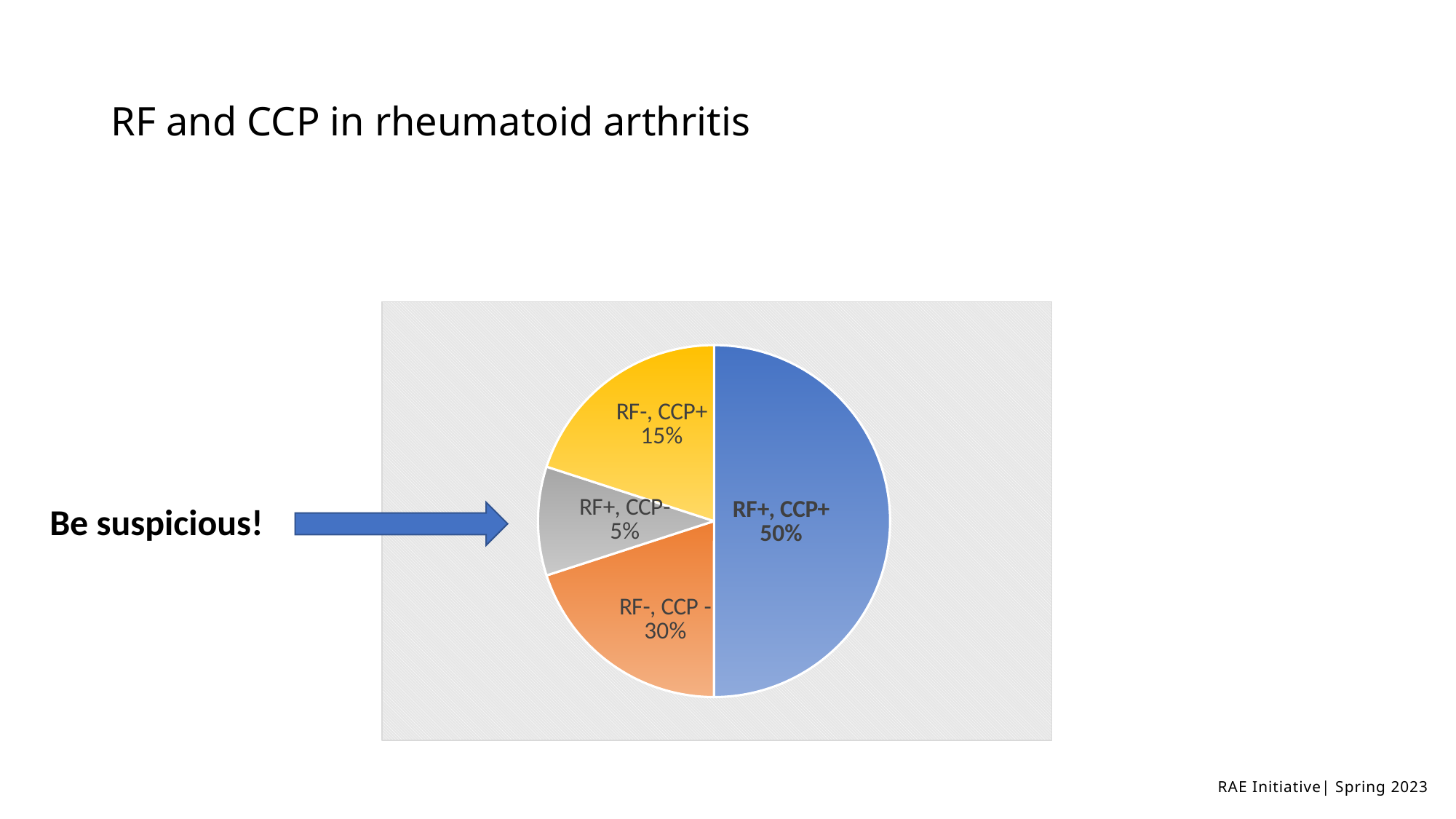
What percentage of the pie is the RF+, CCP+ slice? 50% What percentage of the pie is the RF+, CCP- slice? 5% Which slice of the pie is the largest? RF+, CCP+ What colour is the RF+, CCP+ slice? Blue What percentage of the pie is the RF-, CCP+ slice? 15% What percentage of the pie is the RF-, CCP- slice? 30% Which is larger, the RF-, CCP+ slice or the RF+, CCP- slice? RF-, CCP+ What kind of chart is shown on the slide? Pie chart What is the difference in percentage points between the RF-, CCP- slice and the RF-, CCP+ slice? 15 Which slice of the pie is the smallest? RF+, CCP- How many slices does the pie chart have? 4 What is the title of the slide containing the pie chart? RF and CCP in rheumatoid arthritis